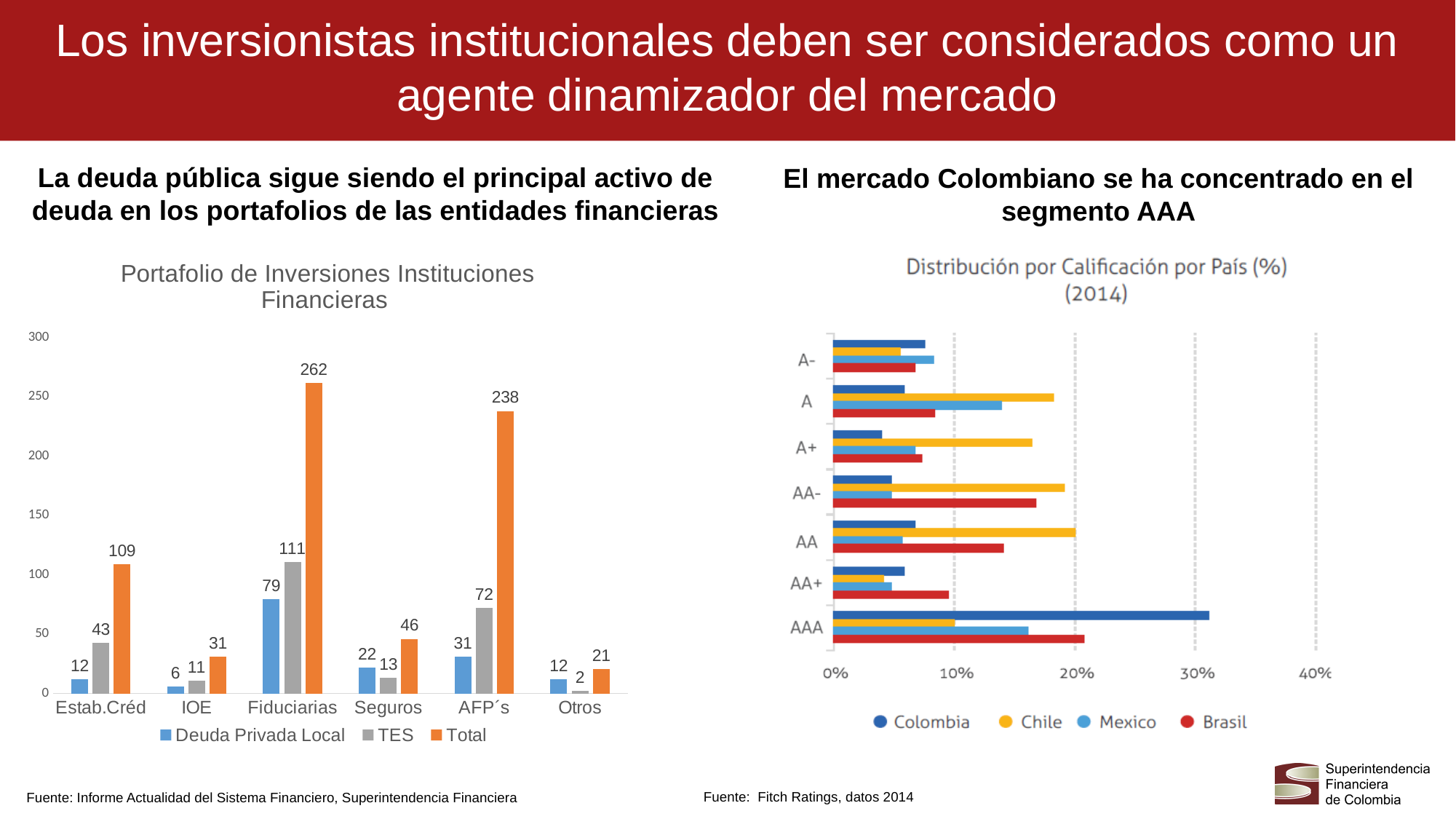
How many categories are shown on the x axis of the 'Portafolio de Inversiones Instituciones Financieras' chart? 6 In the 'Portafolio de Inversiones Instituciones Financieras' chart, which is larger: the TES value for Estab.Créd or the TES value for Seguros? Estab.Créd In the 'Portafolio de Inversiones Instituciones Financieras' chart, what is the Deuda Privada Local value for Seguros? 22 In the 'Portafolio de Inversiones Instituciones Financieras' chart, which category has the highest Total value? Fiduciarias In the 'Distribución por Calificación por País (%) (2014)' chart, is the value for Colombia in the AAA segment greater or less than 30%? greater How many series does the legend of the 'Portafolio de Inversiones Instituciones Financieras' chart list? 3 What kind of chart is the 'Distribución por Calificación por País (%) (2014)' chart on the right? Bar chart In the 'Portafolio de Inversiones Instituciones Financieras' chart, what is the TES value for AFP´s? 72 In the 'Portafolio de Inversiones Instituciones Financieras' chart, what is the Total value for Fiduciarias? 262 How many countries does the legend of the 'Distribución por Calificación por País (%) (2014)' chart list? 4 In the 'Portafolio de Inversiones Instituciones Financieras' chart, what is the difference between the Total values for Fiduciarias and AFP´s? 24 In the 'Portafolio de Inversiones Instituciones Financieras' chart, which category has the lowest TES value? Otros